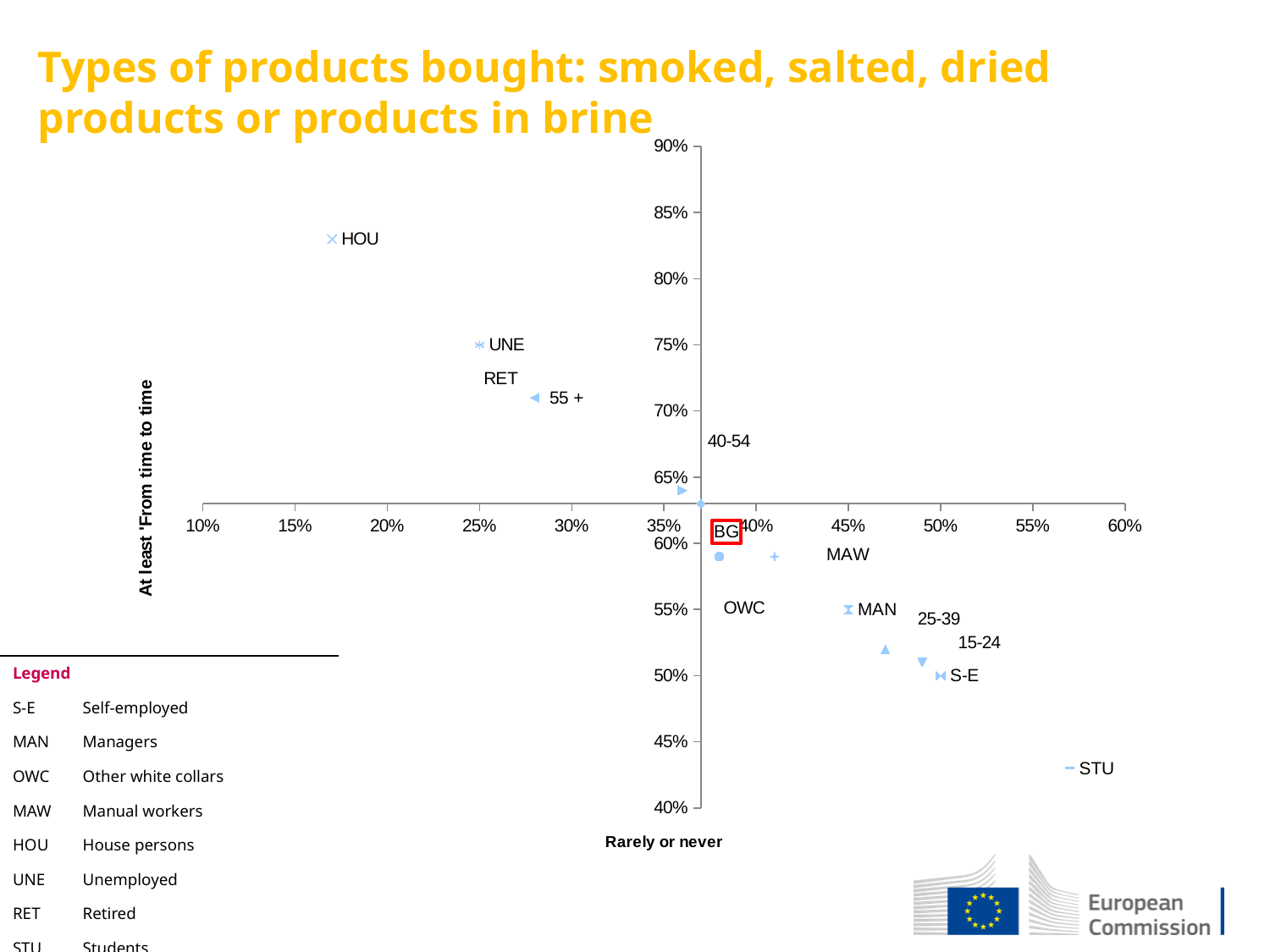
Which labelled point has the lowest value on the vertical axis (At least 'From time to time')? STU What kind of chart is shown on the slide? scatter chart What is the title of the horizontal axis? Rarely or never Is the horizontal-axis (Rarely or never) value for STU greater or less than 55%? greater Is the horizontal-axis (Rarely or never) value for HOU greater or less than 20%? less Is the vertical-axis value for MAN greater or less than 60%? less Which labelled point has the highest value on the vertical axis (At least 'From time to time')? HOU Which has the higher vertical-axis value, HOU or STU? HOU Which labelled point has the lowest value on the horizontal axis (Rarely or never)? HOU Which labelled point has the highest value on the horizontal axis (Rarely or never)? STU As the 'Rarely or never' value increases along the horizontal axis, do the vertical-axis values of the points generally rise or fall? fall